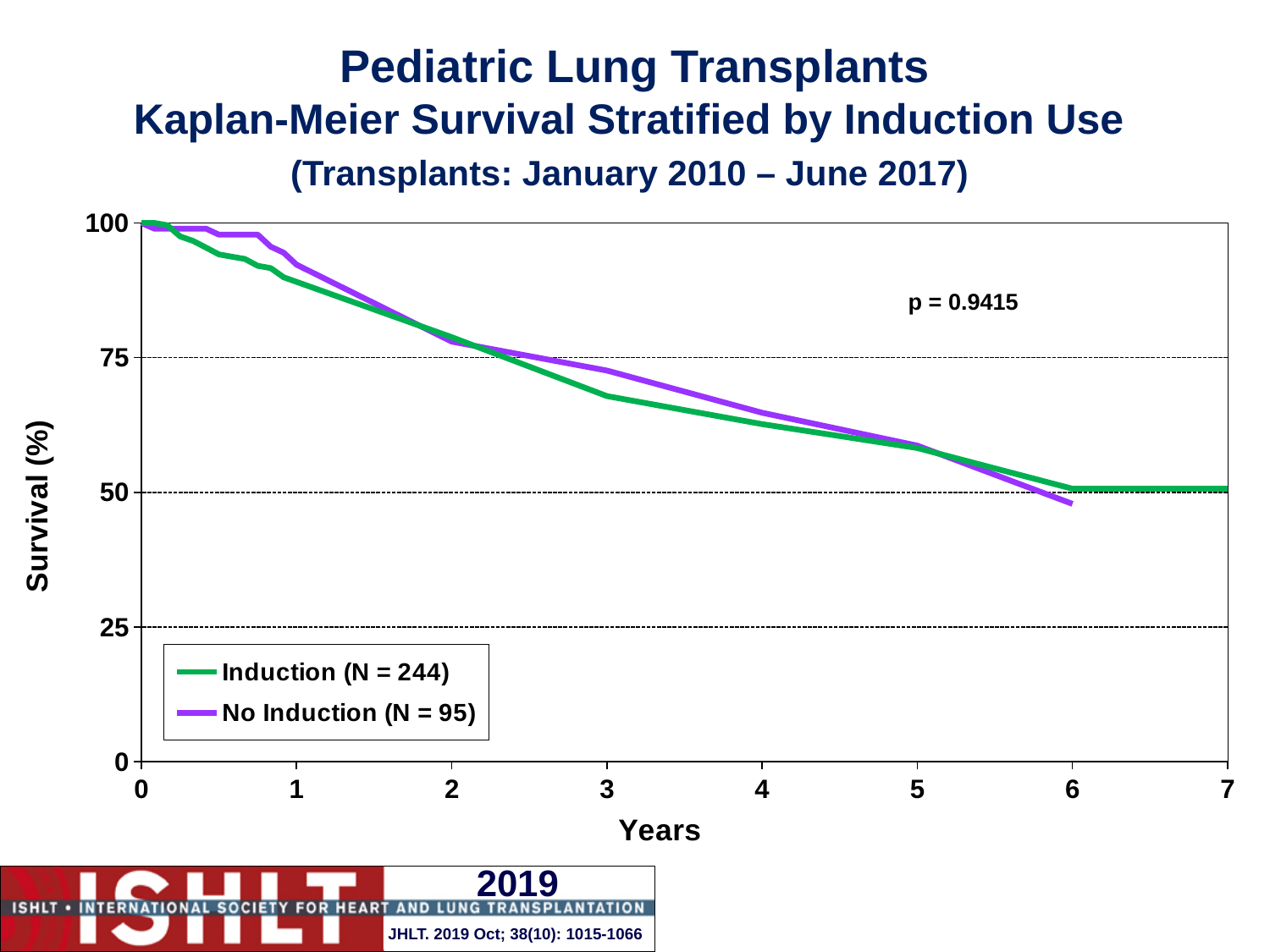
What is the N for the Induction group according to the legend? 244 What kind of chart is shown on the slide? Line chart At year 3, which group has the higher survival, Induction or No Induction? No Induction What p-value is shown on the chart? p = 0.9415 Is the survival value for the No Induction group at year 4 greater or less than 75? less Do the survival curves rise or fall as years increase? Fall How many series does the legend list? 2 Is the survival value for the Induction group at year 4 greater or less than 50? greater Is the survival value for the Induction group at year 3 greater or less than 75? less What is the maximum value shown on the x axis (Years)? 7